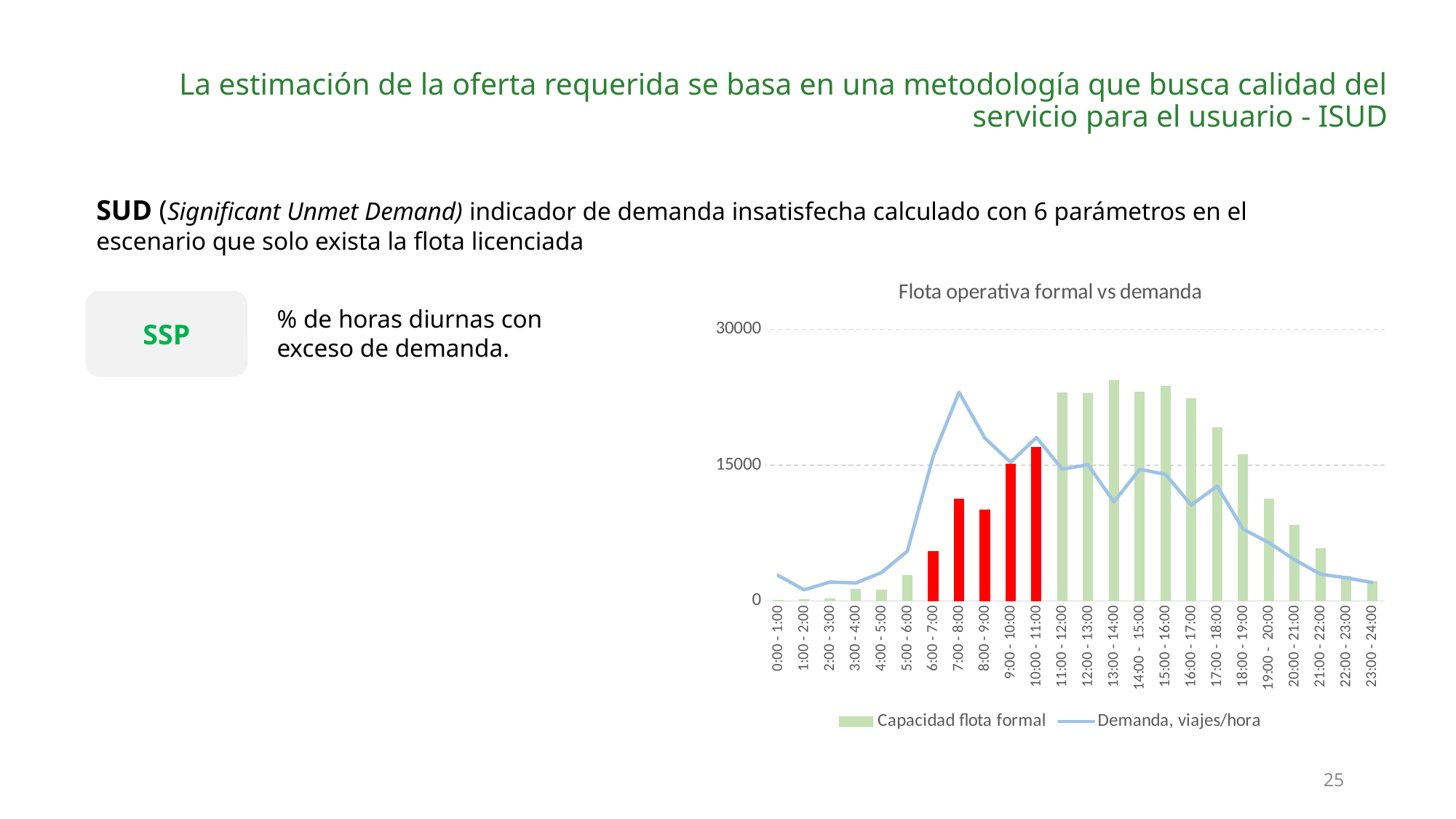
Is the 'Capacidad flota formal' bar for 13:00 - 14:00 greater or less than 15000? greater Is the 'Demanda, viajes/hora' value at 7:00 - 8:00 greater or less than 15000? greater At which hour does the 'Demanda, viajes/hora' line reach its highest value? 7:00 - 8:00 Is the 'Capacidad flota formal' bar for 6:00 - 7:00 greater or less than 15000? less Which is larger: the 'Capacidad flota formal' bar for 13:00 - 14:00 or for 6:00 - 7:00? 13:00 - 14:00 What are the two series named in the chart legend? Capacidad flota formal; Demanda, viajes/hora How many hourly categories are shown on the x axis of the chart? 24 Do the 'Capacidad flota formal' bars generally rise or fall from 15:00 - 16:00 to 23:00 - 24:00? fall What kind of chart is 'Flota operativa formal vs demanda'? A combined bar and line chart How many series does the legend of the chart list? 2